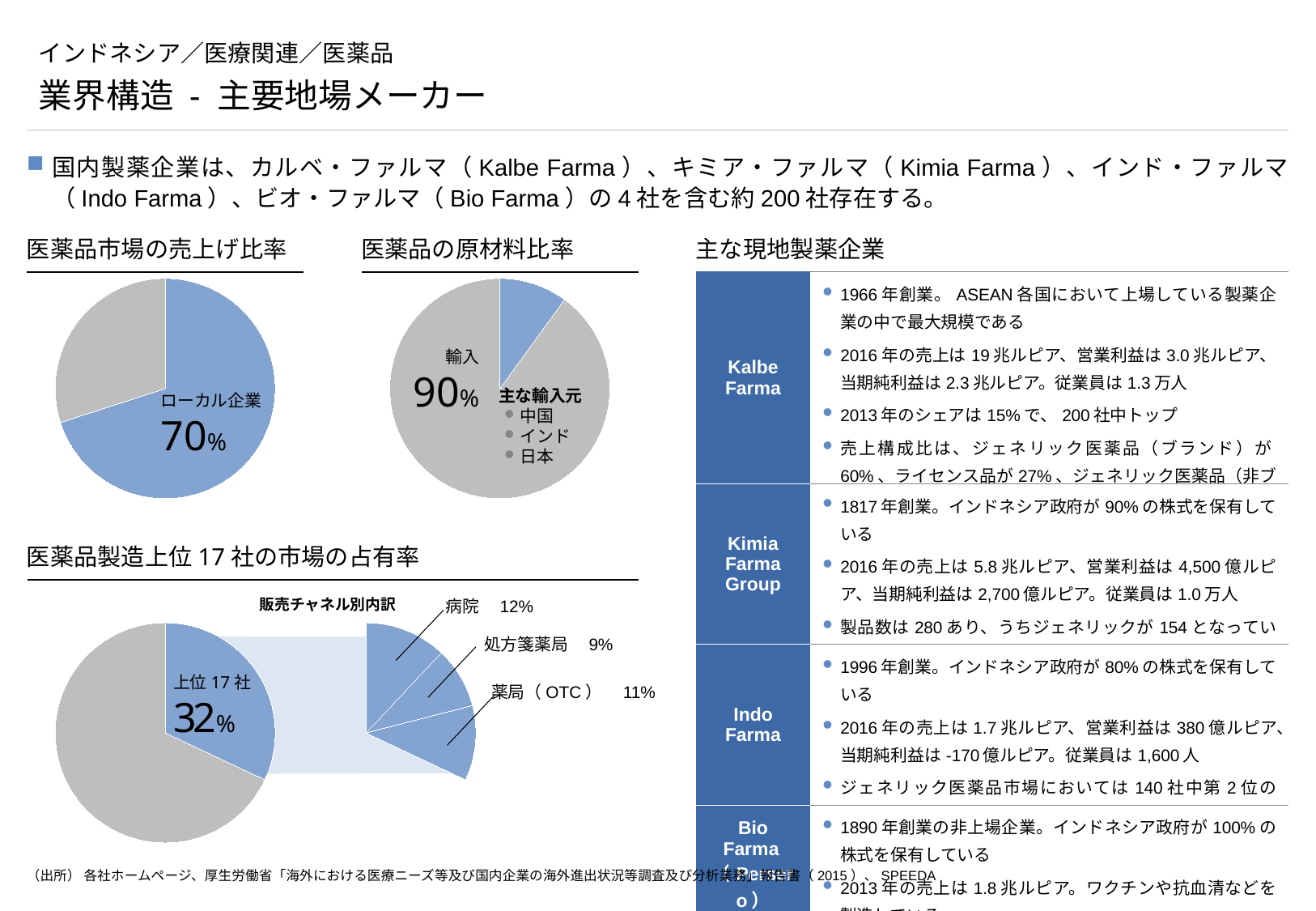
In the 販売チャネル別内訳 breakdown, what is the difference between the 病院 share and the 処方箋薬局 share? 3% In the 医薬品市場の売上げ比率 pie chart, what share is labelled for ローカル企業? 70% In the 医薬品製造上位17社の市場の占有率 chart, what share is labelled for 上位17社? 32% In the 販売チャネル別内訳 breakdown of the 医薬品製造上位17社の市場の占有率 chart, which channel has the lowest share? 処方箋薬局 In the 医薬品製造上位17社の市場の占有率 chart, what is the value for 処方箋薬局 in the 販売チャネル別内訳 breakdown? 9% How many sales channels are shown in the 販売チャネル別内訳 breakdown of the 医薬品製造上位17社の市場の占有率 chart? 3 In the 医薬品製造上位17社の市場の占有率 chart, what is the value for 病院 in the 販売チャネル別内訳 breakdown? 12% In the 販売チャネル別内訳 breakdown, which is larger: 薬局（OTC） or 処方箋薬局? 薬局（OTC） In the 販売チャネル別内訳 breakdown of the 医薬品製造上位17社の市場の占有率 chart, which channel has the highest share? 病院 In the 医薬品の原材料比率 pie chart, what share is labelled for 輸入? 90% What kind of chart is used for 医薬品市場の売上げ比率? Pie chart In the 医薬品製造上位17社の市場の占有率 chart, what is the value for 薬局（OTC）? 11%